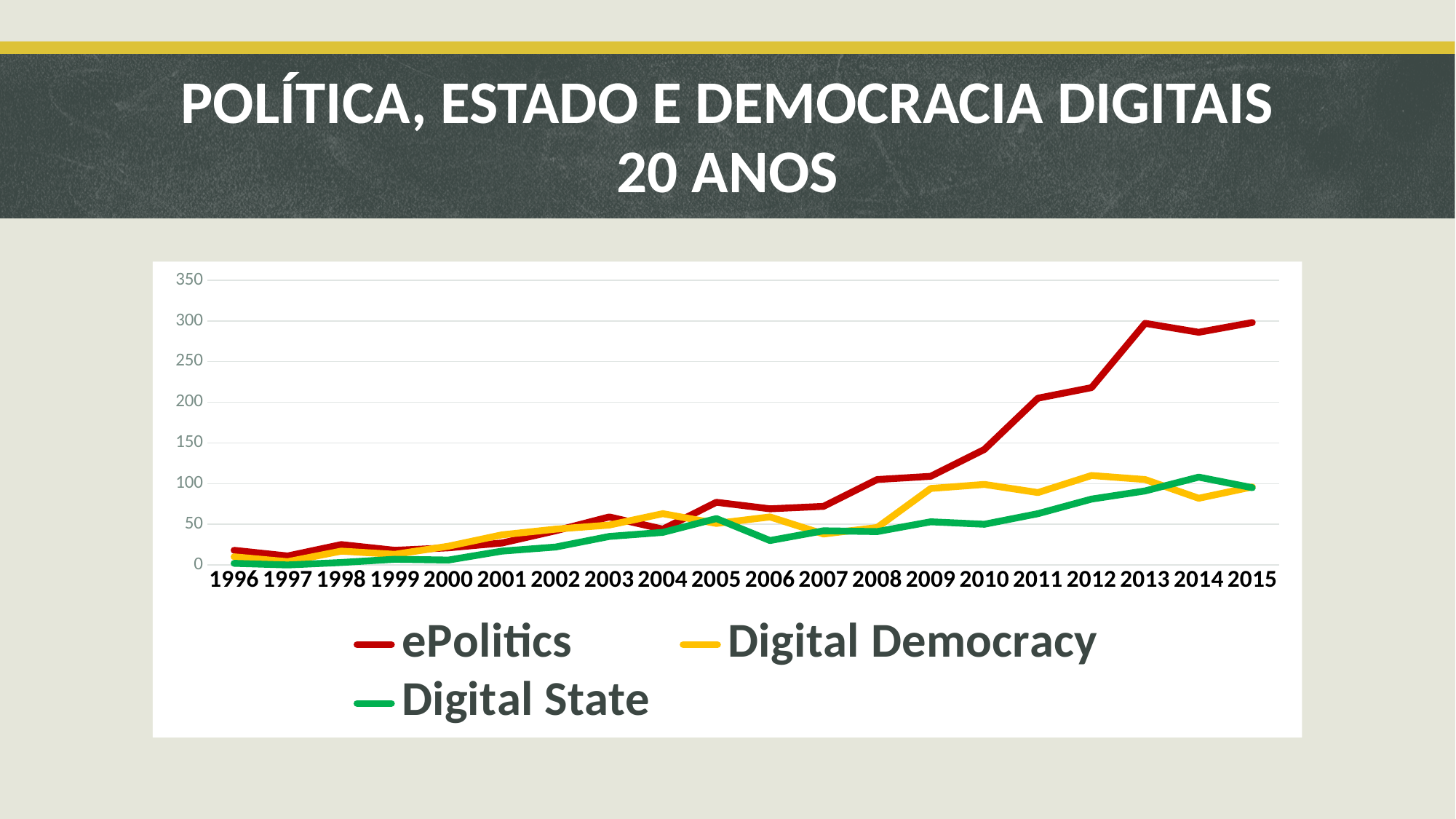
Is the value for Digital State in 2006 greater or less than 50? less In 2015, which is larger: ePolitics or Digital State? ePolitics Does the ePolitics line rise or fall between 2008 and 2013? rise What kind of chart is shown on the slide? line chart Is the value for Digital Democracy in 2014 greater or less than 100? less Is the value for ePolitics in 1996 greater or less than 50? less Which series has the highest value in 2015? ePolitics How many series does the legend list? 3 Which series has the lowest value in 2006? Digital State How many years are shown along the x axis? 20